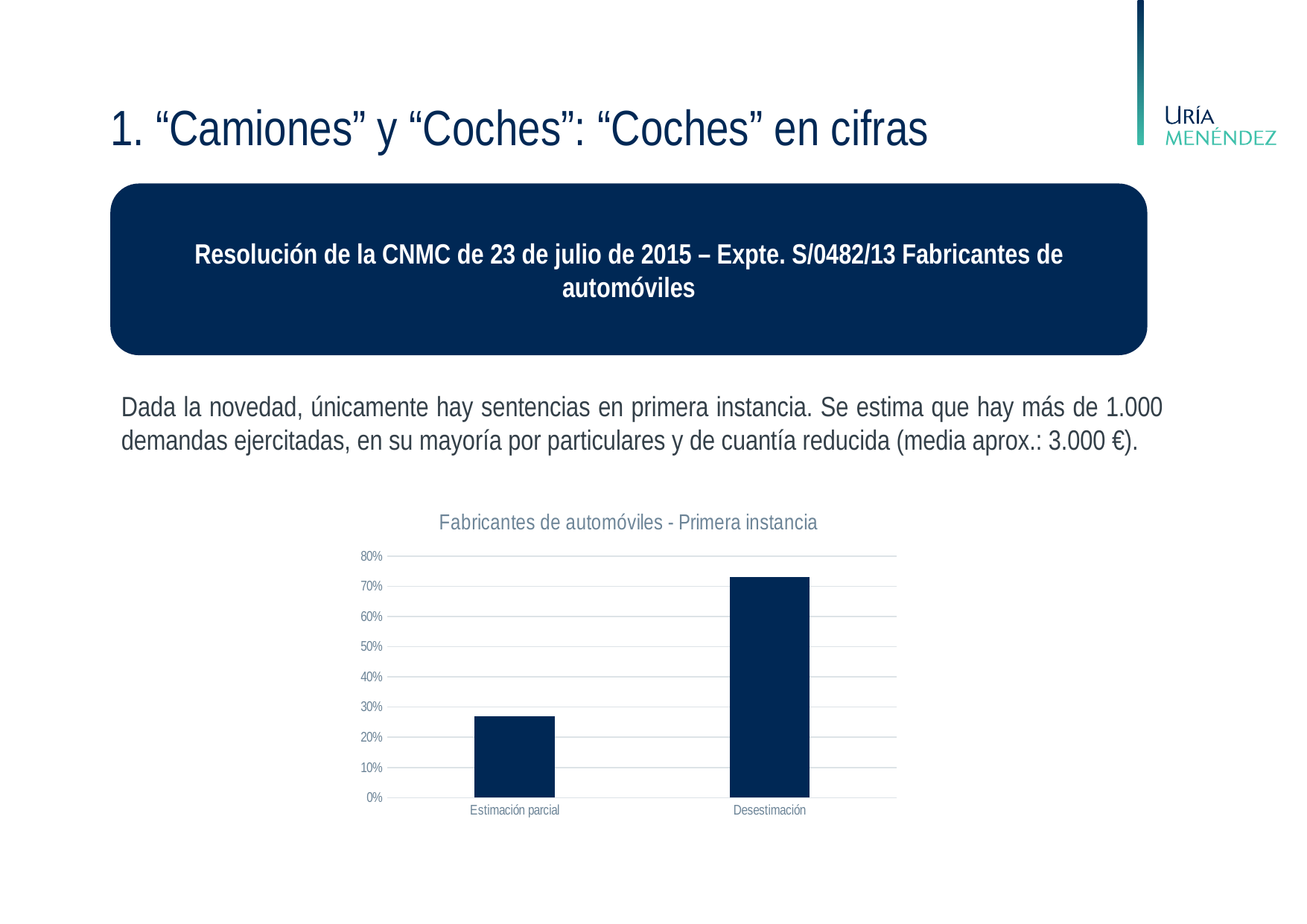
How many categories are shown on the x axis of the chart? 2 Which category has the lowest value in the chart? Estimación parcial Is the value for Estimación parcial greater or less than 20%? greater What is the highest value shown on the y axis of the chart? 80% Which category has the highest value in the chart? Desestimación Is the value for Desestimación greater or less than 70%? greater Is the value for Estimación parcial greater or less than 30%? less Which is larger, the value for Estimación parcial or the value for Desestimación? Desestimación What is the title of the chart? Fabricantes de automóviles - Primera instancia What kind of chart is shown on the slide? bar chart